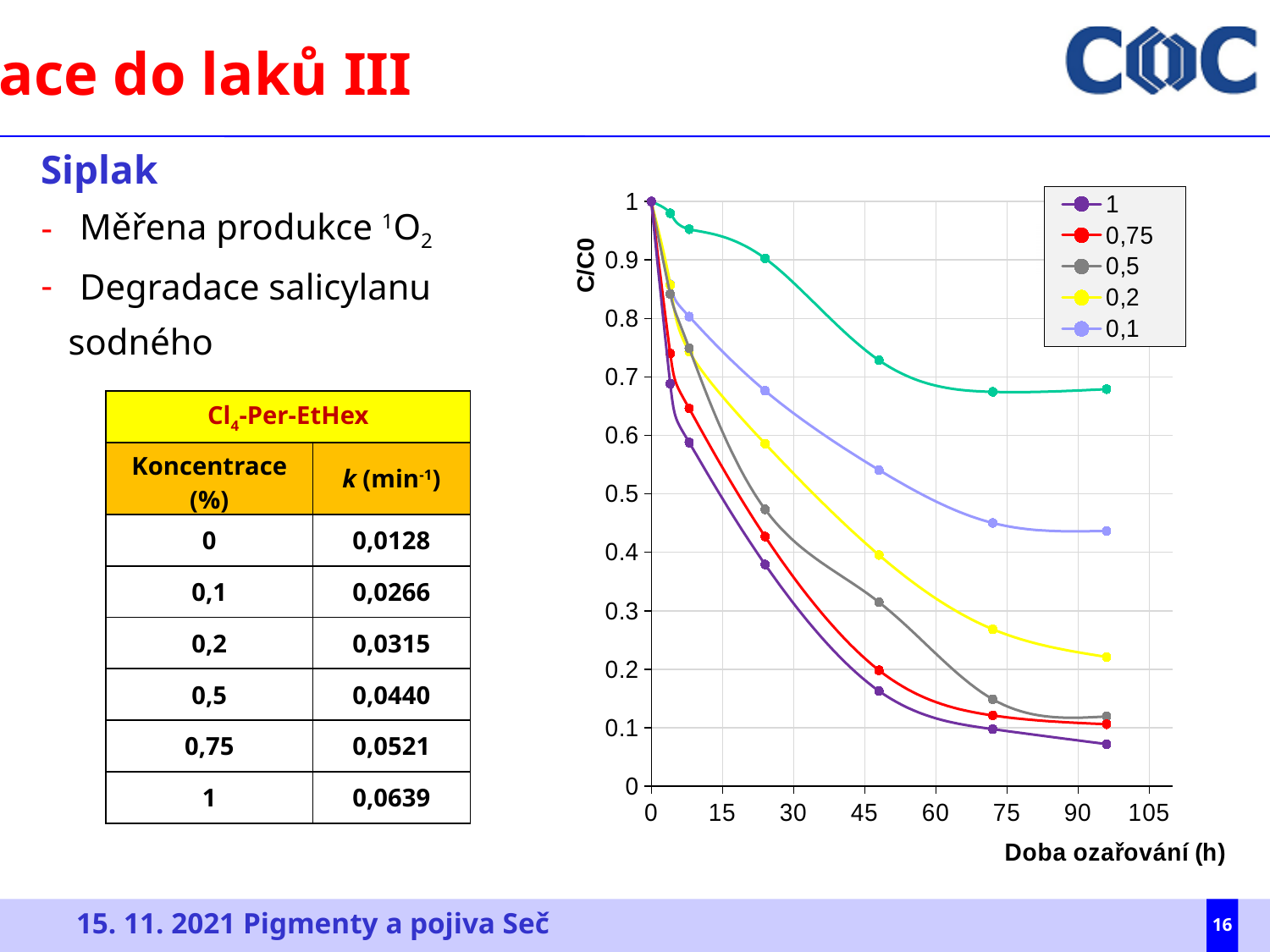
What is the label of the x axis of the chart? Doba ozařování (h) Do the C/C0 values for the series "1" rise or fall as irradiation time increases? fall Is the value for the series "0,1" at 24 h greater or less than 0.6? greater At 48 h, which series has the larger C/C0 value: "0,2" or "0,5"? 0,2 Is the value for the series "0,1" at 96 h greater or less than 0.5? less Among the series listed in the legend, which has the lowest C/C0 value at 96 h? 1 What is the label of the y axis of the chart? C/C0 What kind of chart is shown on the slide? line chart Among the series listed in the legend, which has the highest C/C0 value at 96 h? 0,1 Is the value for the series "1" at 96 h greater or less than 0.1? less How many series does the chart legend list? 5